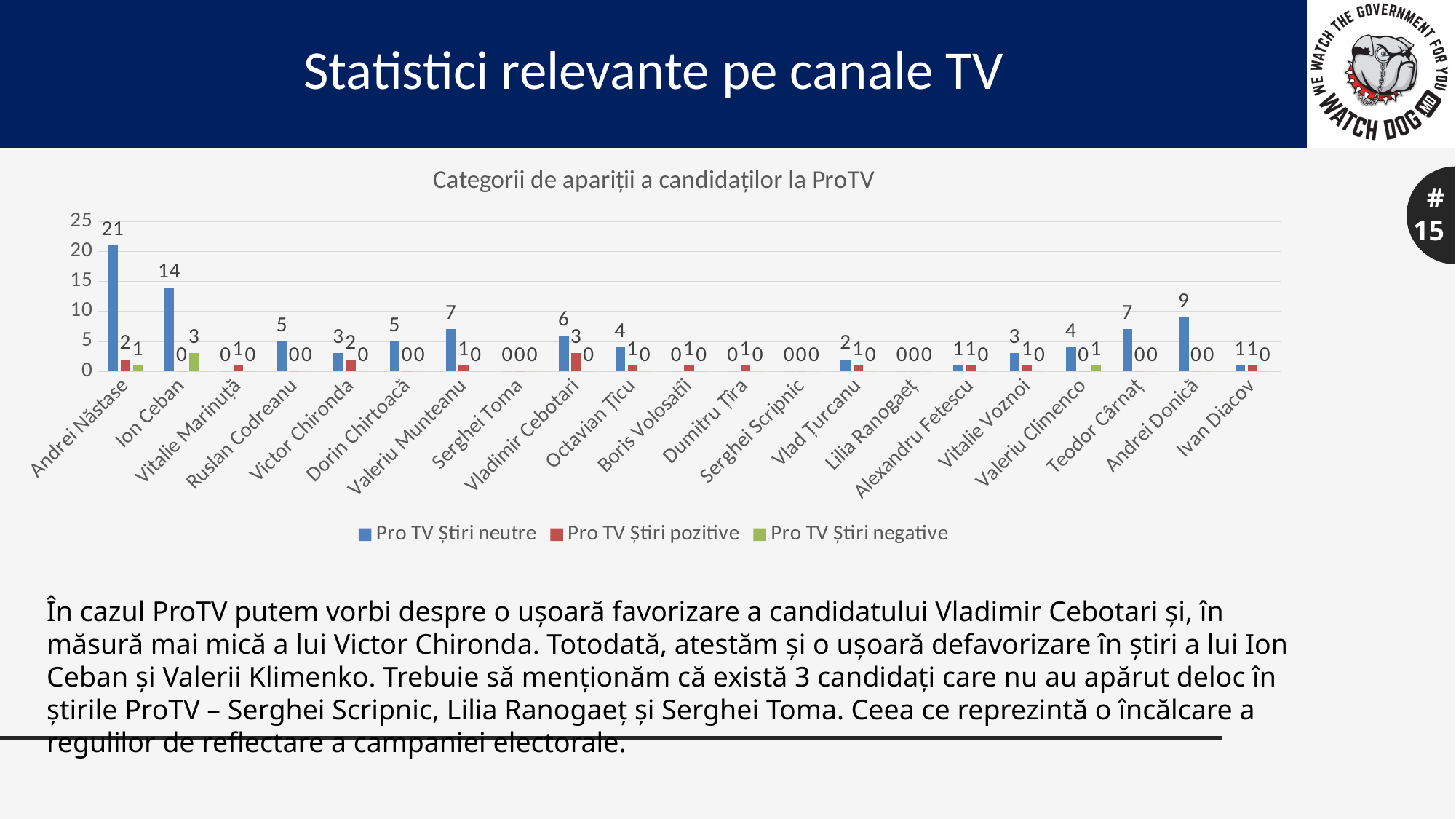
What is the value of Pro TV Știri negative for Ion Ceban? 3 How many series does the legend list? 3 What is the title of the chart? Categorii de apariții a candidaților la ProTV What is the value of Pro TV Știri neutre for Andrei Năstase? 21 Which candidate has the highest value for Pro TV Știri pozitive? Vladimir Cebotari What is the value of Pro TV Știri neutre for Andrei Donică? 9 Which candidate has the highest value for Pro TV Știri neutre? Andrei Năstase What is the difference between the Pro TV Știri neutre values for Andrei Năstase and Ion Ceban? 7 What kind of chart is shown on the slide? Bar chart What is the value of Pro TV Știri pozitive for Vladimir Cebotari? 3 How many candidates are shown on the x axis of the chart? 21 Which is larger: the Pro TV Știri neutre value for Valeriu Munteanu or for Vladimir Cebotari? Valeriu Munteanu